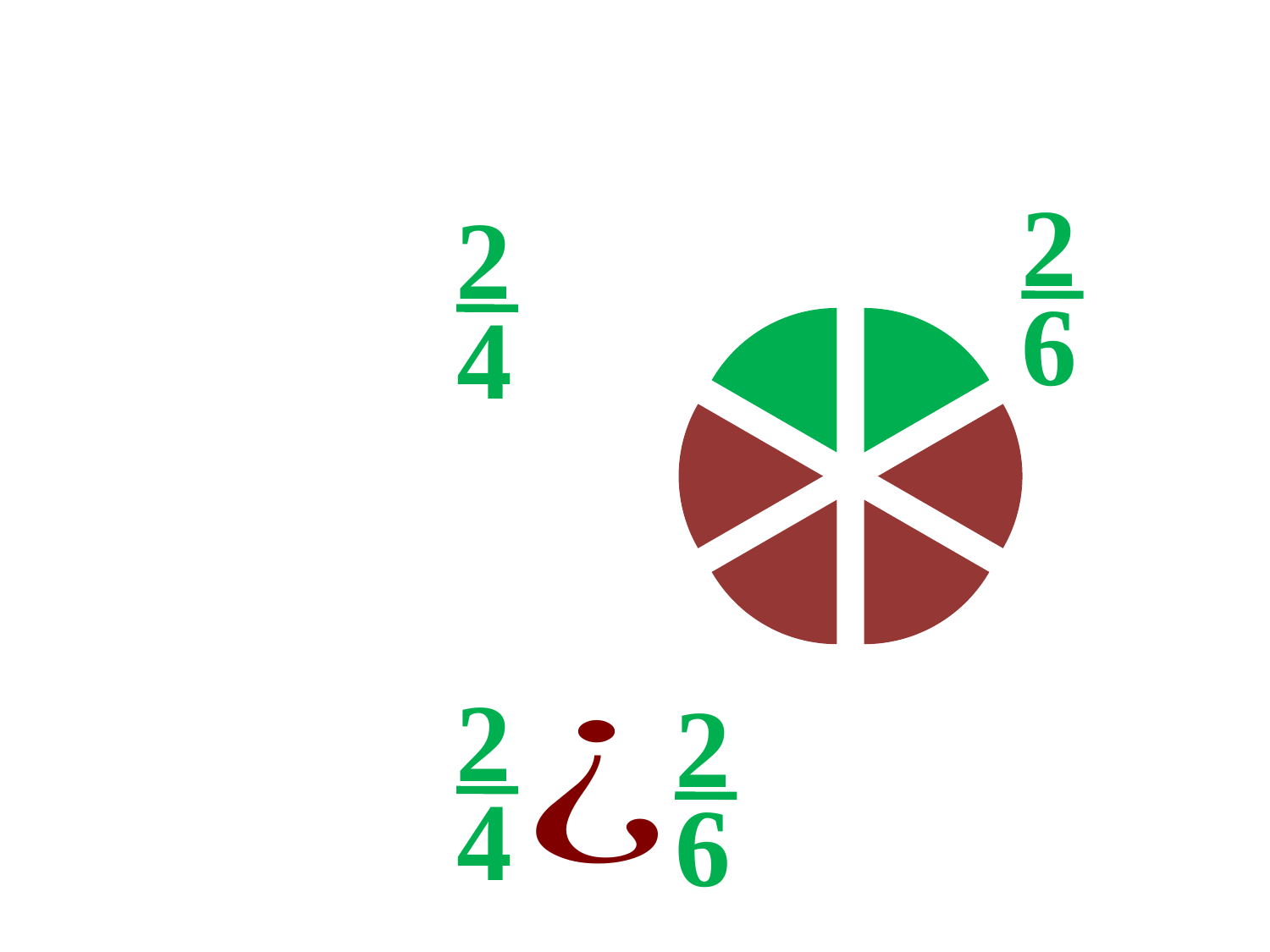
How many slices of the pie chart are dark red? 4 Are the slices of the pie chart all the same size? yes How many slices does the pie chart have? 6 What fraction is written next to the pie chart, at its upper right? 2/6 What kind of chart is shown on the slide? pie chart Which colour covers the smaller part of the pie chart? green Which colour covers the larger part of the pie chart, green or dark red? dark red How many slices of the pie chart are green? 2